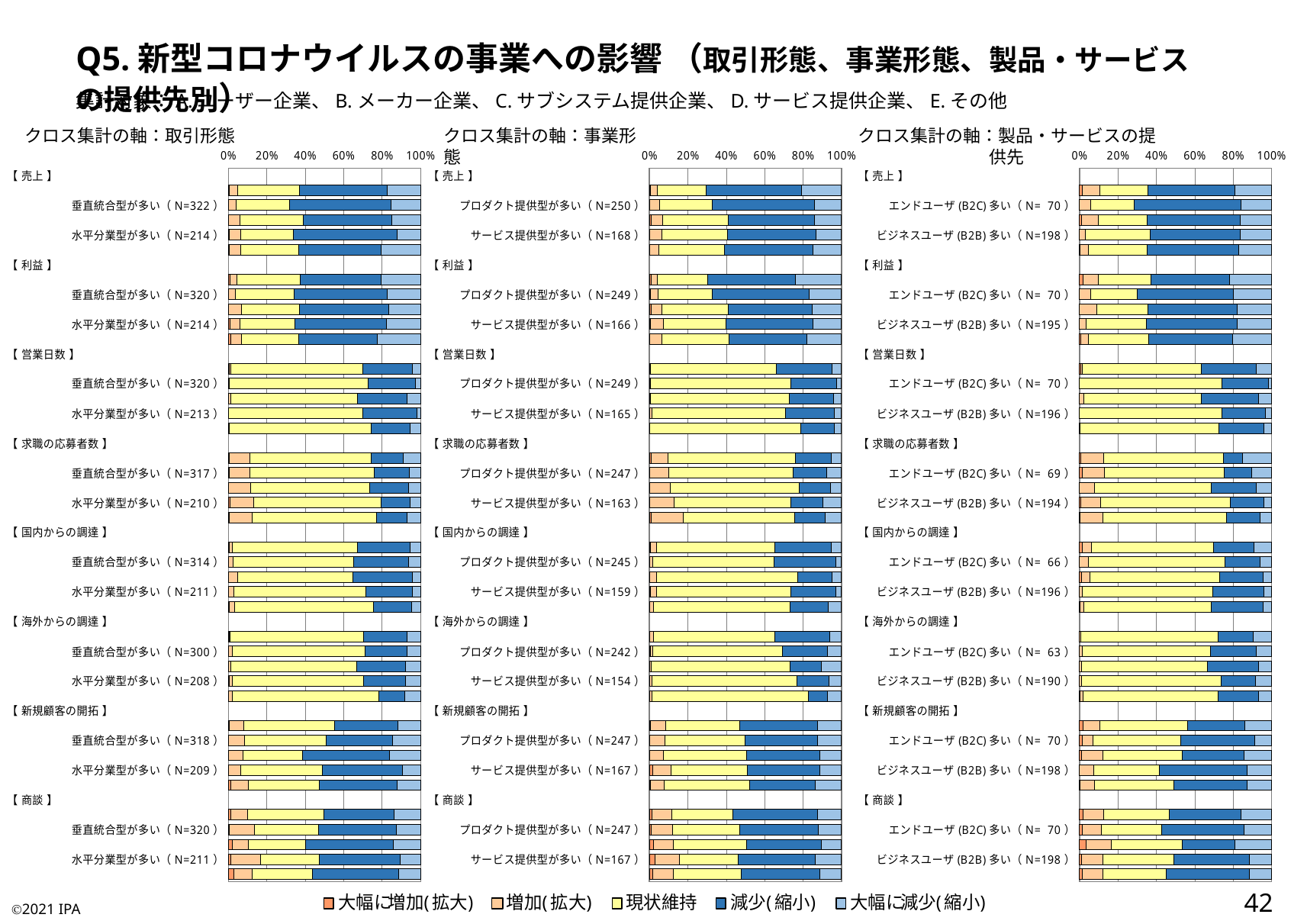
In the left chart, which has the larger 現状維持 share: 営業日数 垂直統合型が多い (N=320) or 商談 垂直統合型が多い (N=320)? 営業日数 垂直統合型が多い (N=320) What is the first legend entry shown at the bottom of the slide? 大幅に増加(拡大) In the left chart, is the 現状維持 share for 営業日数 垂直統合型が多い (N=320) greater or less than 60%? greater How many item groups (e.g. 売上, 利益, 営業日数 ...) does the middle chart (クロス集計の軸：事業形態) contain? 8 How many series does the legend at the bottom of the slide list? 5 What is the cross-tabulation axis label of the right chart? クロス集計の軸：製品・サービスの提供先 How many charts are shown on the slide? 3 What is the maximum value shown on the horizontal axis of each chart? 100% What kind of chart is the left chart (クロス集計の軸：取引形態)? Stacked bar chart In the left chart, is the 減少(縮小) share for the top 営業日数 bar greater or less than 40%? less In the right chart, is the 現状維持 share for 営業日数 エンドユーザ(B2C)多い (N=70) greater or less than 40%? greater